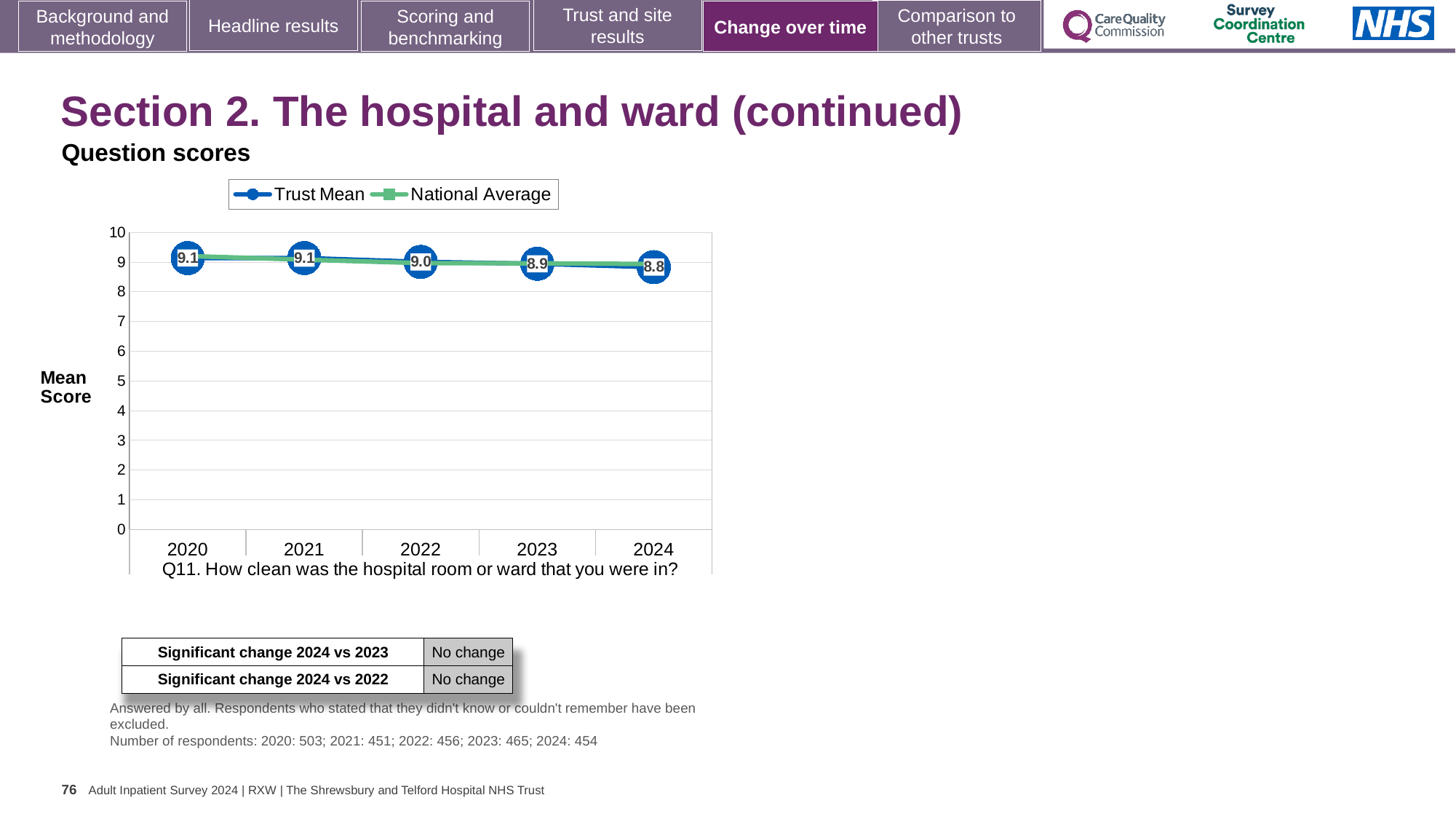
What is the Trust Mean value for 2022? 9.0 What is the Trust Mean value for 2023? 8.9 What is the difference between the Trust Mean in 2020 and in 2024? 0.3 Which year has the larger Trust Mean, 2021 or 2023? 2021 Does the Trust Mean rise or fall from 2020 to 2024? Fall Is the National Average value for 2024 greater or less than 8? greater What is the Trust Mean value for 2020? 9.1 How many series does the legend list? 2 What is the Trust Mean value for 2024? 8.8 How many years are plotted on the x axis? 5 In which year is the Trust Mean lowest? 2024 What kind of chart is shown? Line chart